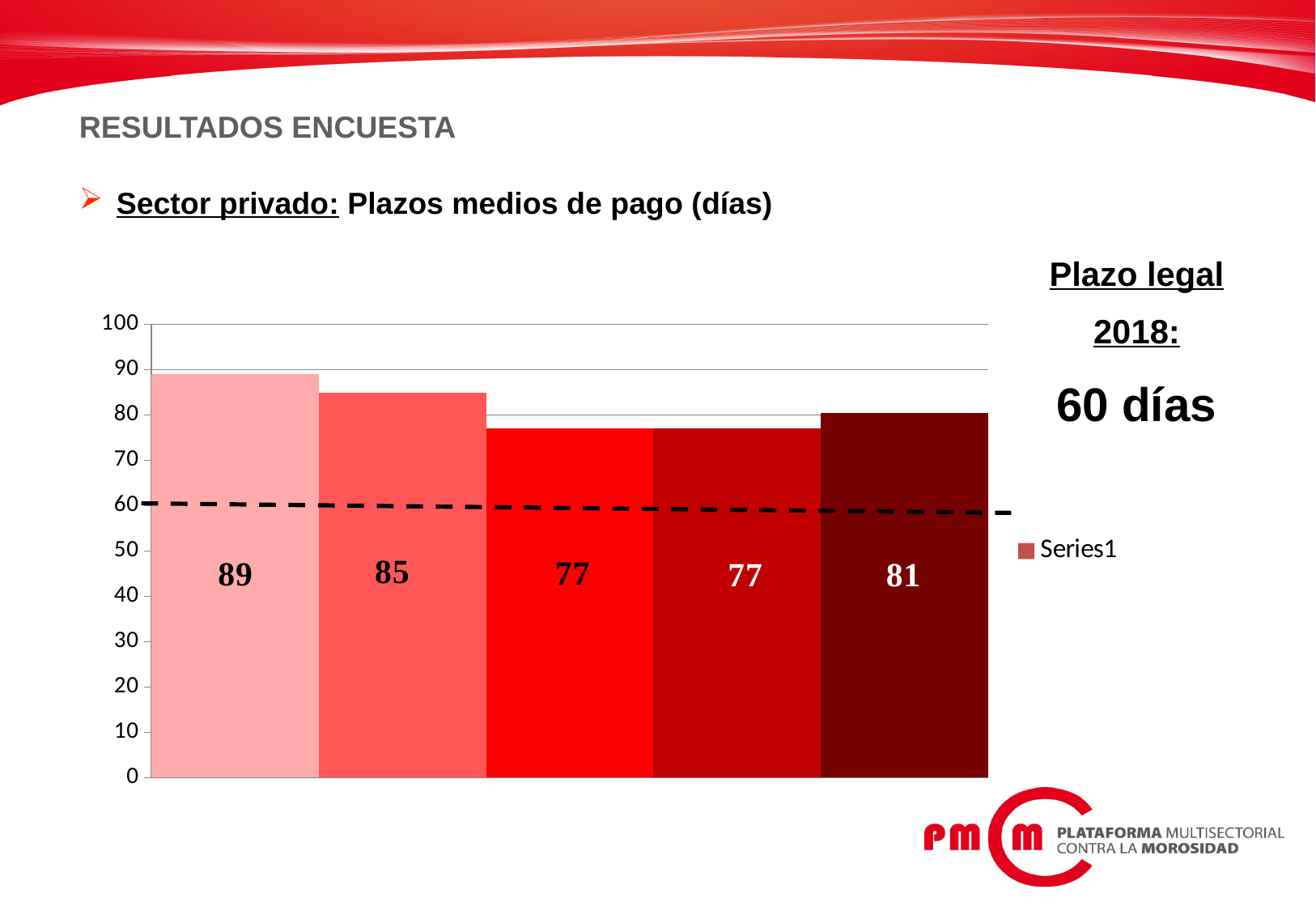
Which is larger, the value of the second bar or the value of the fifth bar? the second bar (85) What is the name of the series shown in the chart legend? Series1 What is the highest value shown among the bars in the chart? 89 What is the value of the second bar from the left in the chart? 85 What is the value of the last (rightmost) bar in the chart? 81 How many series does the chart legend list? 1 Is the value of the third bar greater or less than 60? greater What is the lowest value shown among the bars in the chart? 77 What type of chart is shown on the slide? bar chart What is the value of the first (leftmost) bar in the chart? 89 How many bars are plotted in the chart? 5 What is the difference between the first bar (89) and the last bar (81)? 8